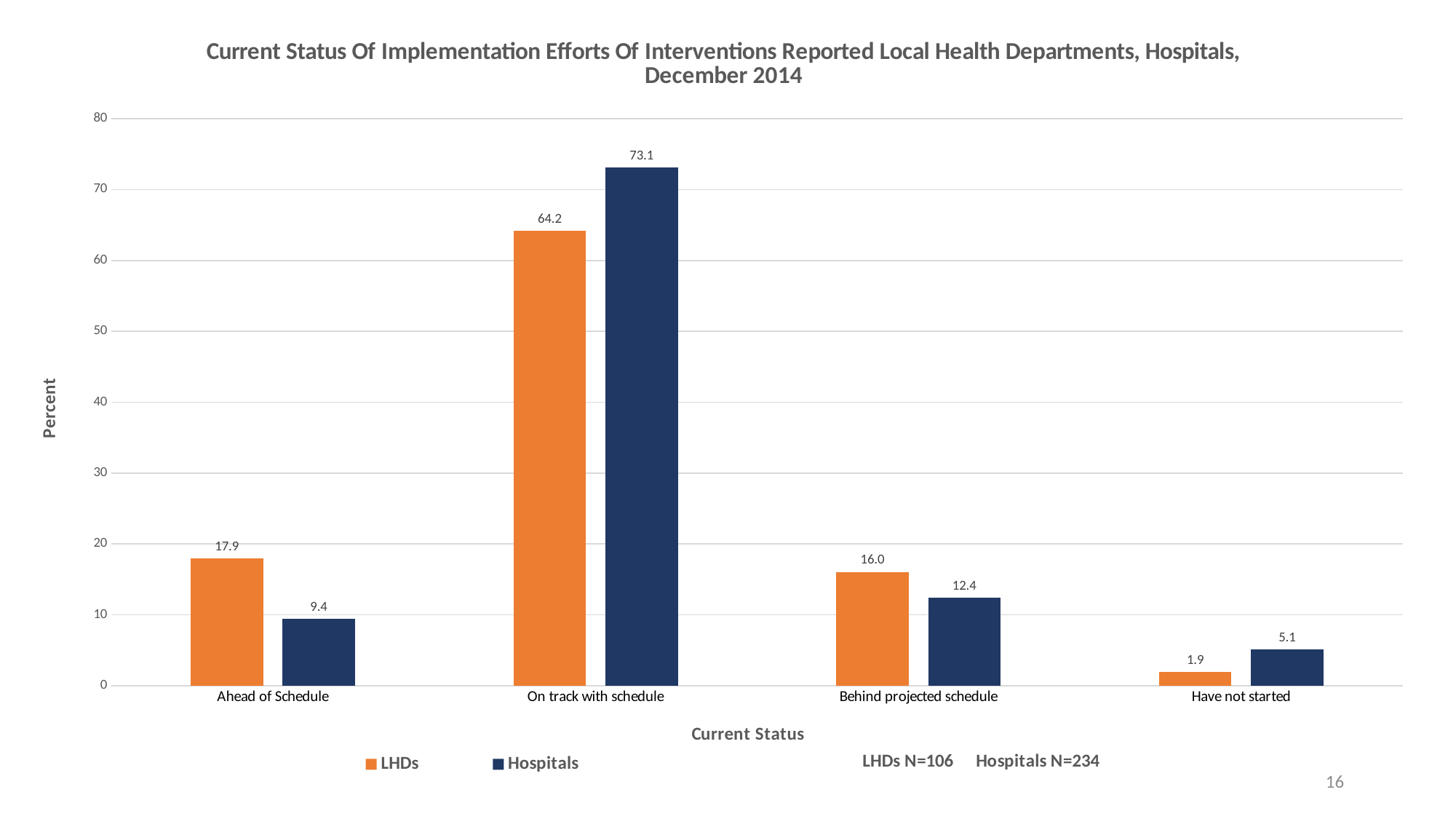
How many categories are shown on the x axis? 4 What is the value for Hospitals in the 'Have not started' category? 5.1 What is the label of the y axis? Percent What is the value for LHDs in the 'On track with schedule' category? 64.2 Which category has the highest value for Hospitals? On track with schedule Which category has the lowest value for LHDs? Have not started What kind of chart is shown on the slide? Bar chart Which is larger in the 'Behind projected schedule' category, LHDs or Hospitals? LHDs What is the difference between the Hospitals and LHDs values in the 'On track with schedule' category? 8.9 Is the value for LHDs in the 'Ahead of Schedule' category greater or less than 20? less What is the value for Hospitals in the 'Ahead of Schedule' category? 9.4 How many series does the legend list? 2